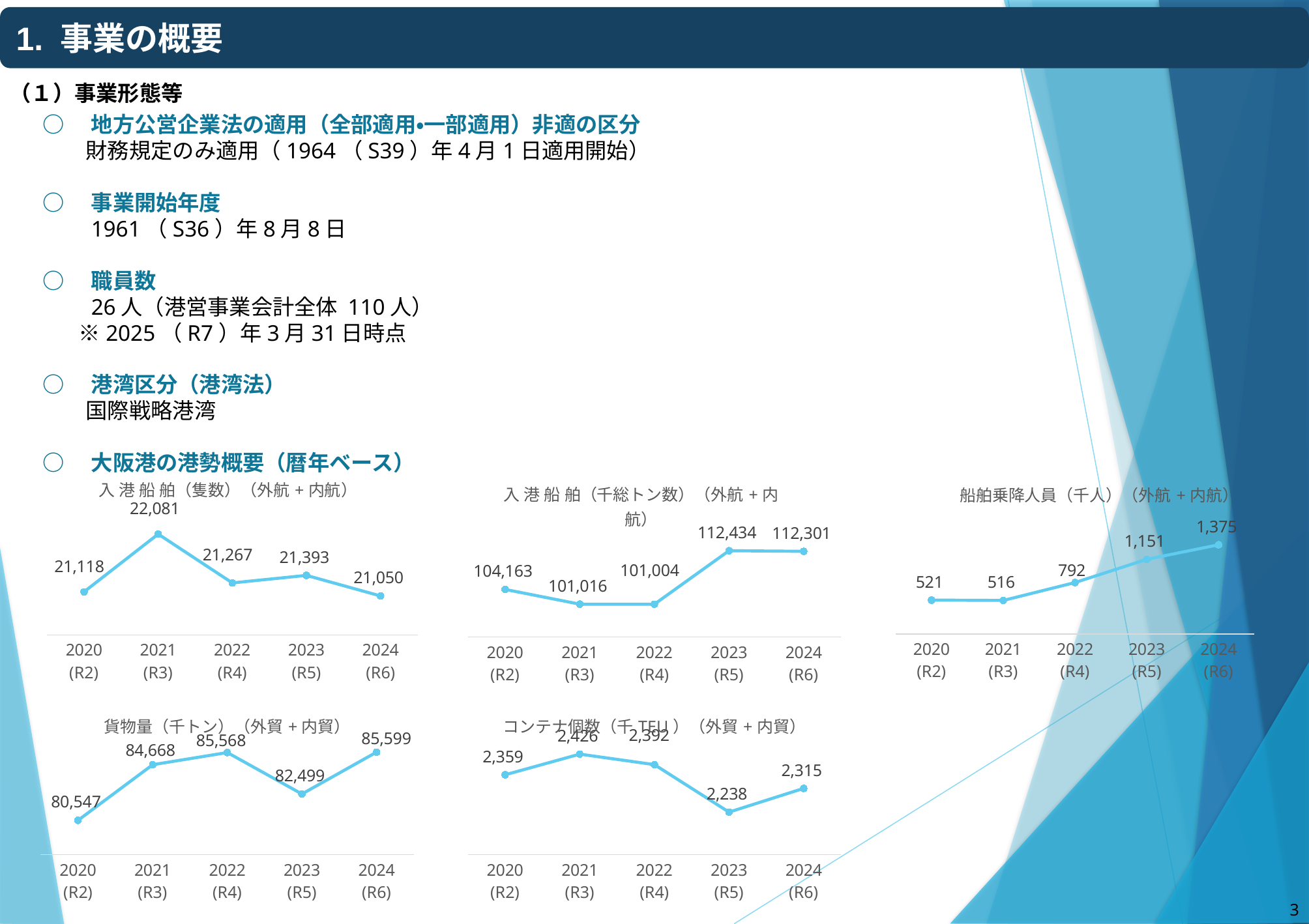
In the 船舶乗降人員（千人） chart (top right), which year has the highest value? 2024 (R6) In the コンテナ個数（千TEU） chart (bottom middle), what is the value for 2023 (R5)? 2,238 In the コンテナ個数（千TEU） chart (bottom middle), how many years are plotted? 5 In the 入港船舶（隻数） chart (top left), what is the value for 2021 (R3)? 22,081 What type of chart is the 貨物量（千トン） chart (bottom left)? line chart In the 入港船舶（千総トン数） chart (top middle), what is the difference between the 2020 (R2) and 2021 (R3) values? 3,147 In the 入港船舶（千総トン数） chart (top middle), what is the value for 2023 (R5)? 112,434 In the 貨物量（千トン） chart (bottom left), which is larger, the value for 2022 (R4) or 2024 (R6)? 2024 (R6) In the 入港船舶（隻数） chart (top left), which year has the lowest value? 2024 (R6) In the 船舶乗降人員（千人） chart (top right), what is the value for 2024 (R6)? 1,375 In the 船舶乗降人員（千人） chart (top right), do the values generally rise or fall from 2021 to 2024? rise In the 貨物量（千トン） chart (bottom left), what is the value for 2023 (R5)? 82,499